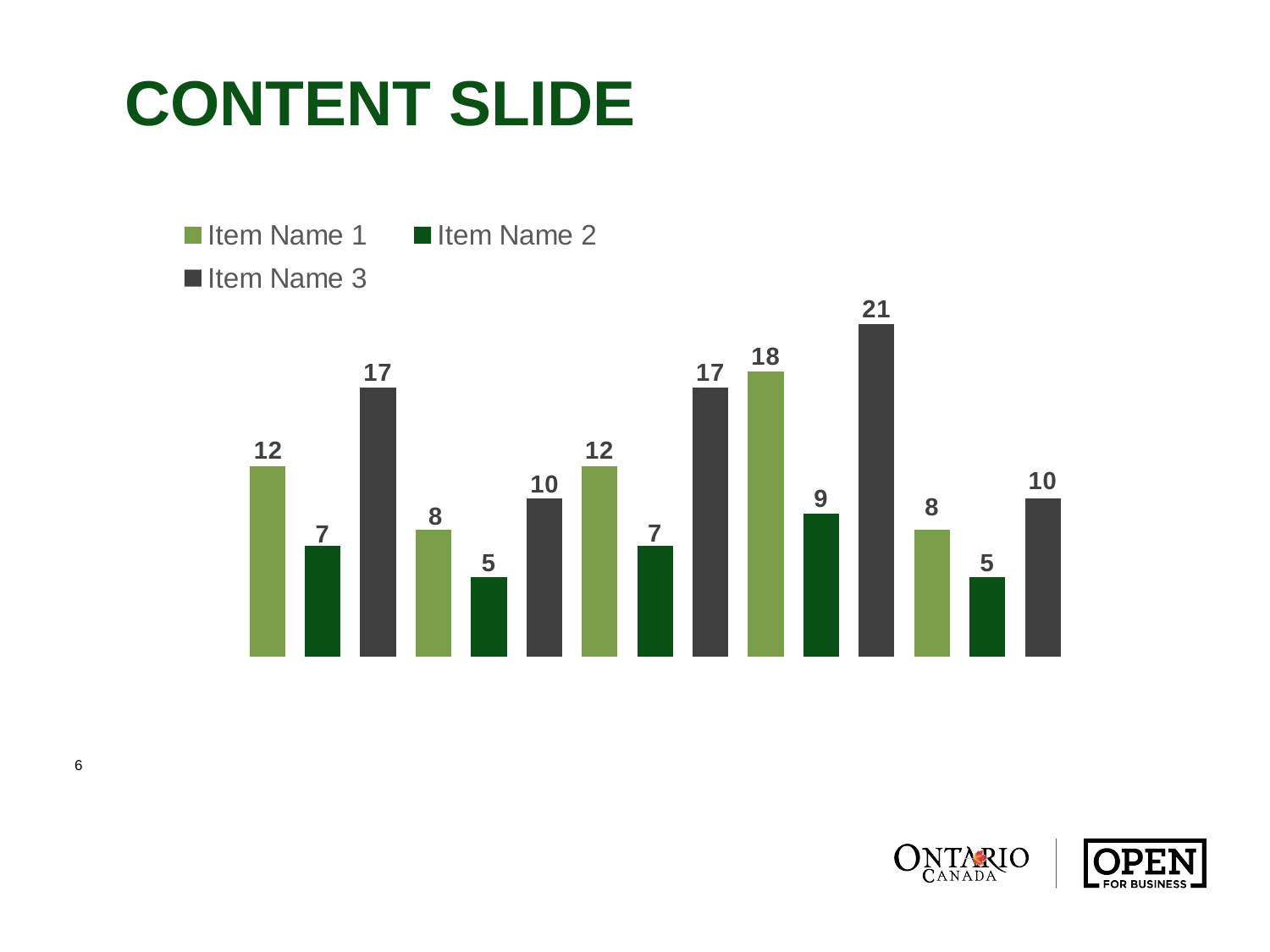
What is the value of Item Name 3 in the first group of bars? 17 How many series does the legend list? 3 What is the lowest value shown for Item Name 2? 5 In the first group of bars, which is larger: Item Name 1 or Item Name 2? Item Name 1 How many groups of bars are plotted in the chart? 5 What is the value of Item Name 1 in the fourth group of bars? 18 What is the value of Item Name 2 in the second group of bars? 5 Which legend entry is shown in light green? Item Name 1 What is the highest value shown for Item Name 3? 21 What kind of chart is shown on the slide? bar chart Which series has the tallest bar in the chart? Item Name 3 In the fourth group of bars, what is the difference between Item Name 3 and Item Name 1? 3